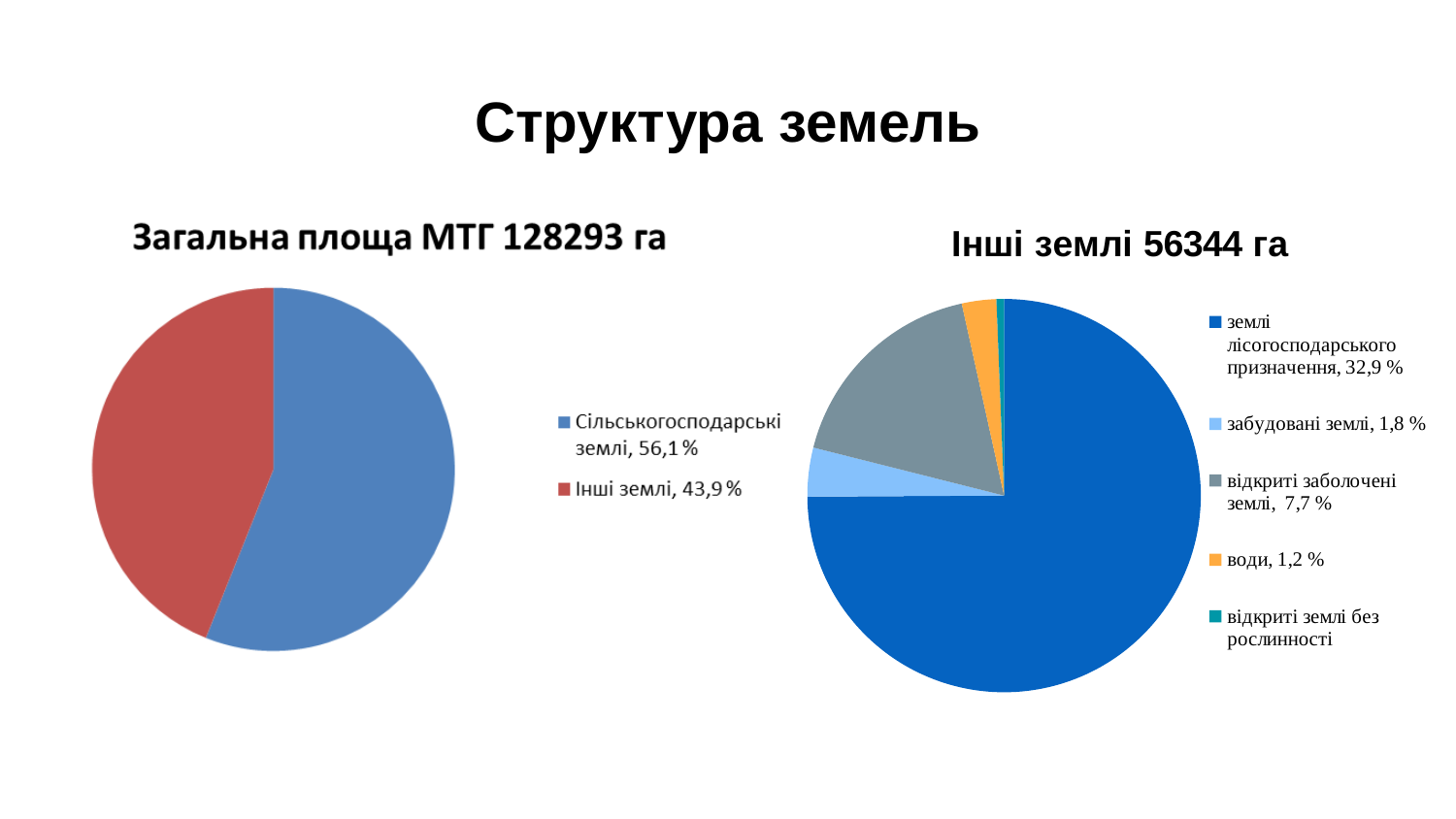
On the left chart "Загальна площа МТГ 128293 га", what is the difference between Сільськогосподарські землі and Інші землі? 12,2 % On the right chart "Інші землі 56344 га", what is the value for землі лісогосподарського призначення? 32,9 % On the left chart "Загальна площа МТГ 128293 га", which category has the larger share? Сільськогосподарські землі On the right chart "Інші землі 56344 га", what is the value for відкриті заболочені землі? 7,7 % On the left chart "Загальна площа МТГ 128293 га", what is the value for Інші землі? 43,9 % On the right chart "Інші землі 56344 га", which is larger: забудовані землі or води? забудовані землі How many categories does the legend of the right chart "Інші землі 56344 га" list? 5 What type of chart is used on the left chart titled "Загальна площа МТГ 128293 га"? Pie chart On the right chart "Інші землі 56344 га", what is the value for води? 1,2 % On the right chart "Інші землі 56344 га", which category has the largest slice? землі лісогосподарського призначення On the left chart "Загальна площа МТГ 128293 га", what is the value for Сільськогосподарські землі? 56,1 % How many categories does the legend of the left chart "Загальна площа МТГ 128293 га" list? 2